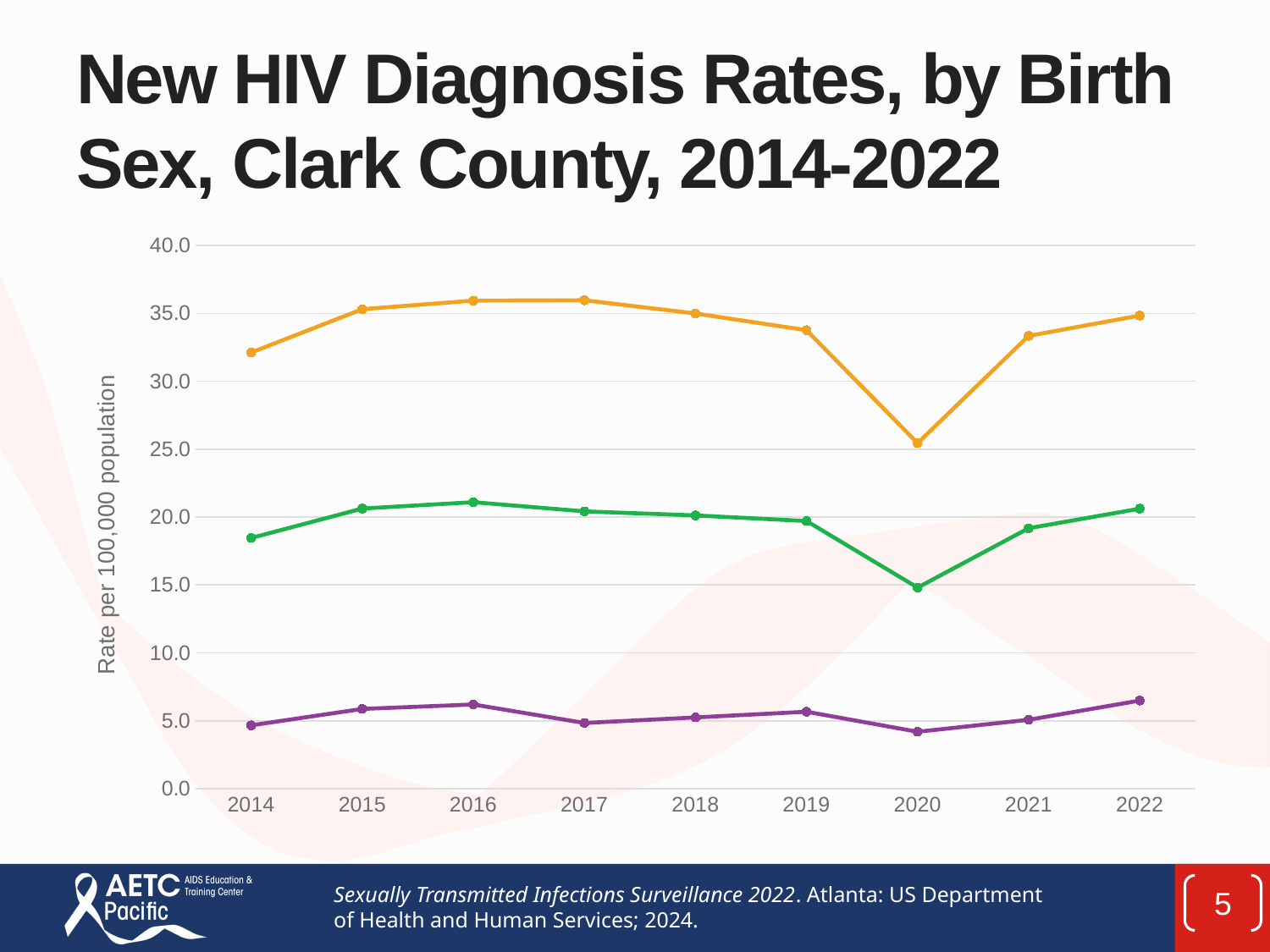
How many lines are plotted on the chart? 3 What is the label on the y axis of the chart? Rate per 100,000 population Is the value of the orange line in 2014 greater or less than 30.0? greater In which year does the orange line reach its lowest value? 2020 Is the value of the orange line in 2020 greater or less than 30.0? less Does the orange line rise or fall from 2020 to 2022? rise Is the value of the green line in 2020 greater or less than 20.0? less What kind of chart is shown on the slide? line chart How many years are shown along the x axis of the chart? 9 In which year does the green line reach its lowest value? 2020 Which line has the higher value in 2018, the orange line or the green line? the orange line